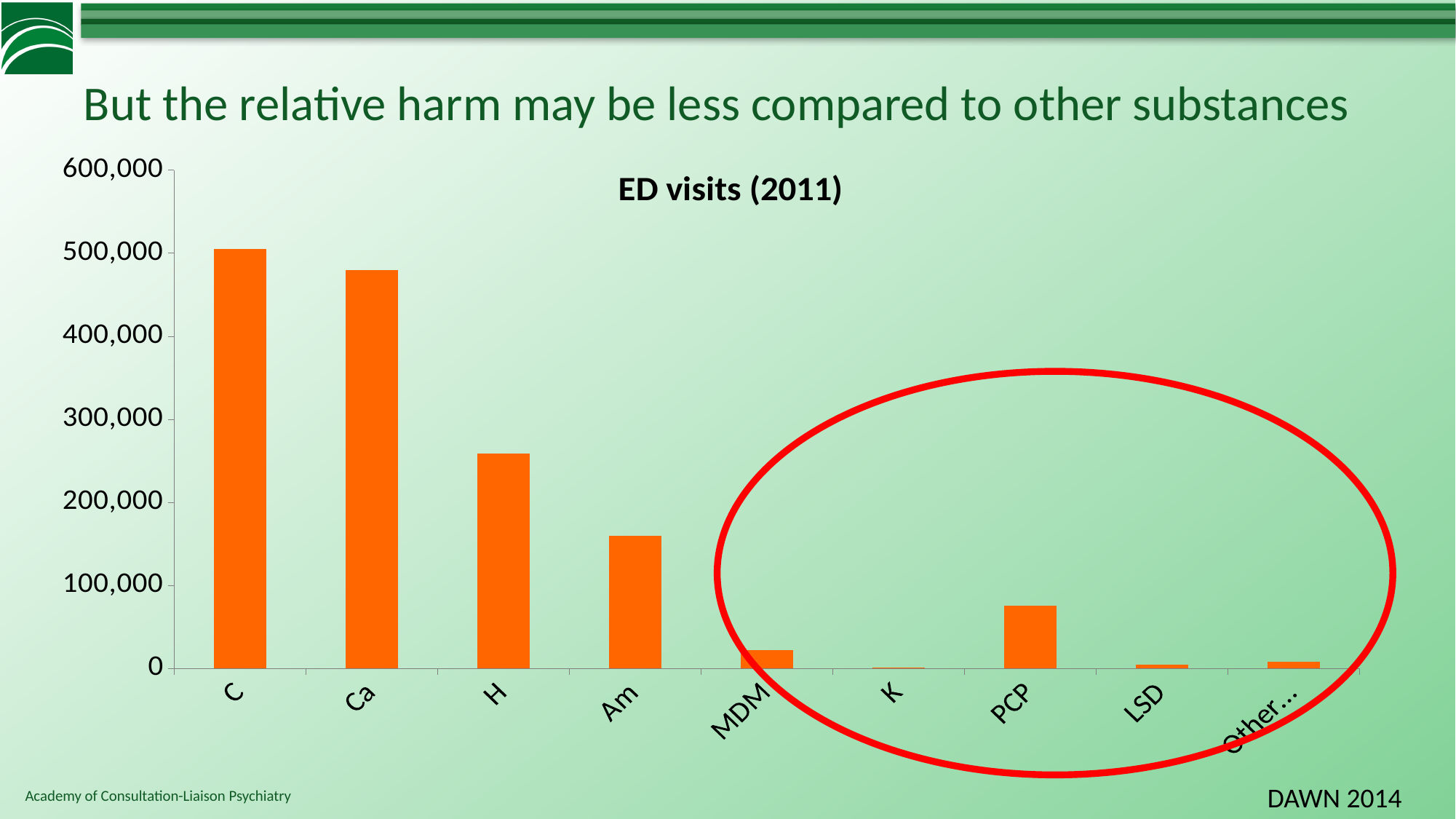
Which category has the highest number of ED visits? C Which has more ED visits, PCP or MDM? PCP Which has more ED visits, H or Am? H Is the value for PCP greater or less than 100,000? less What is the title of the chart? ED visits (2011) Is the value for Ca greater or less than 500,000? less What kind of chart is shown on the slide? bar chart Do the values rise or fall across the first four bars (C, Ca, H, Am) from left to right? fall Is the value for Am greater or less than 100,000? greater How many categories are shown on the x axis of the chart? 9